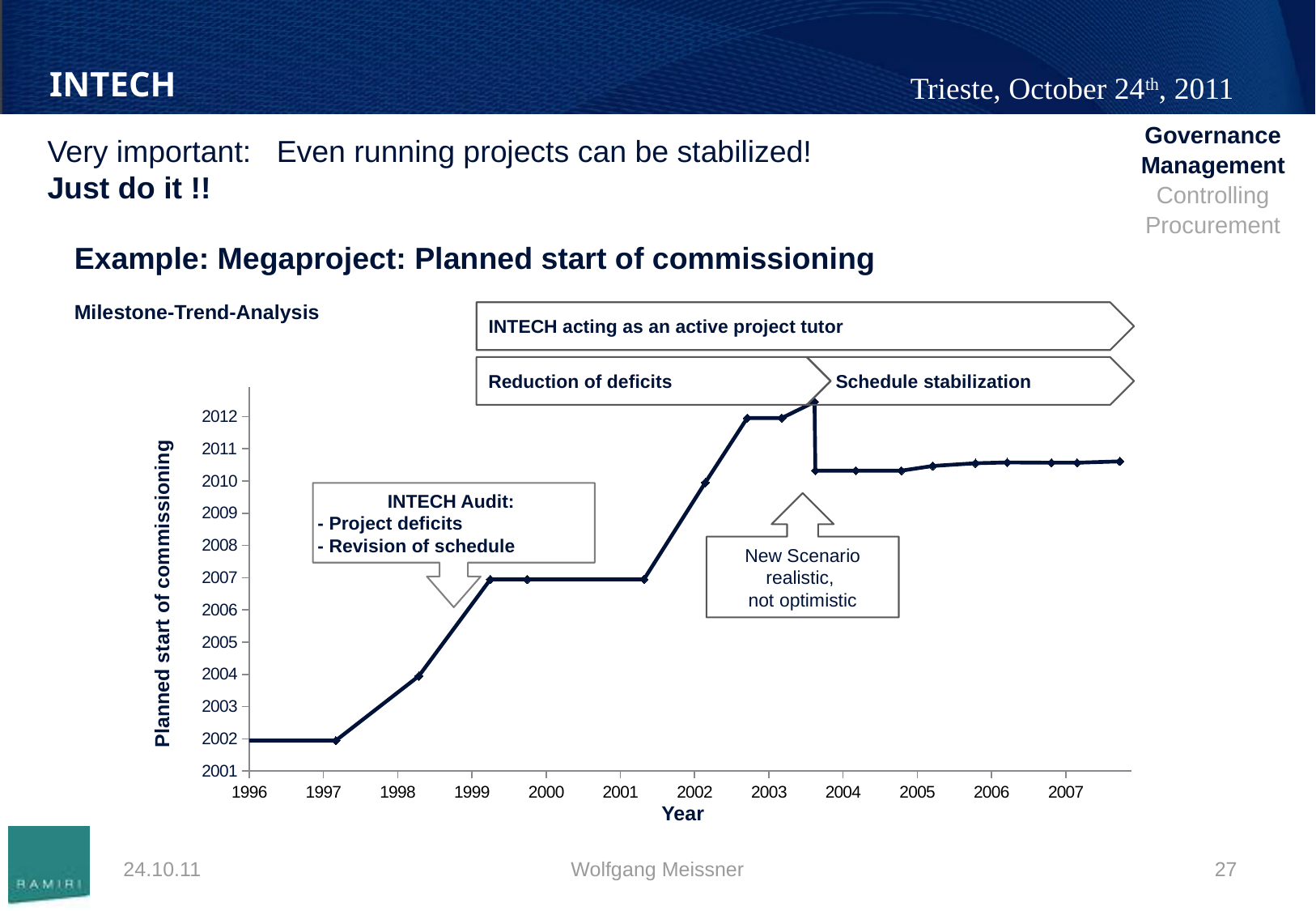
Which is larger, the planned start of commissioning shown for 2003 or for 2007? 2003 What is the title of the y axis of the chart? Planned start of commissioning Is the planned start of commissioning shown for 1998 greater or less than 2005? less Is the planned start of commissioning shown for 2003 greater or less than 2011? greater What is the planned start of commissioning shown for 1996? 2002 What is the title of the x axis of the chart? Year Which is larger, the planned start of commissioning shown for 2001 or for 2006? 2006 Does the planned start of commissioning rise or fall between 1997 and 2003? rise What is the planned start of commissioning shown for 2000? 2007 Is the planned start of commissioning shown for 2005 greater or less than 2011? less What kind of chart is shown on the slide? line chart